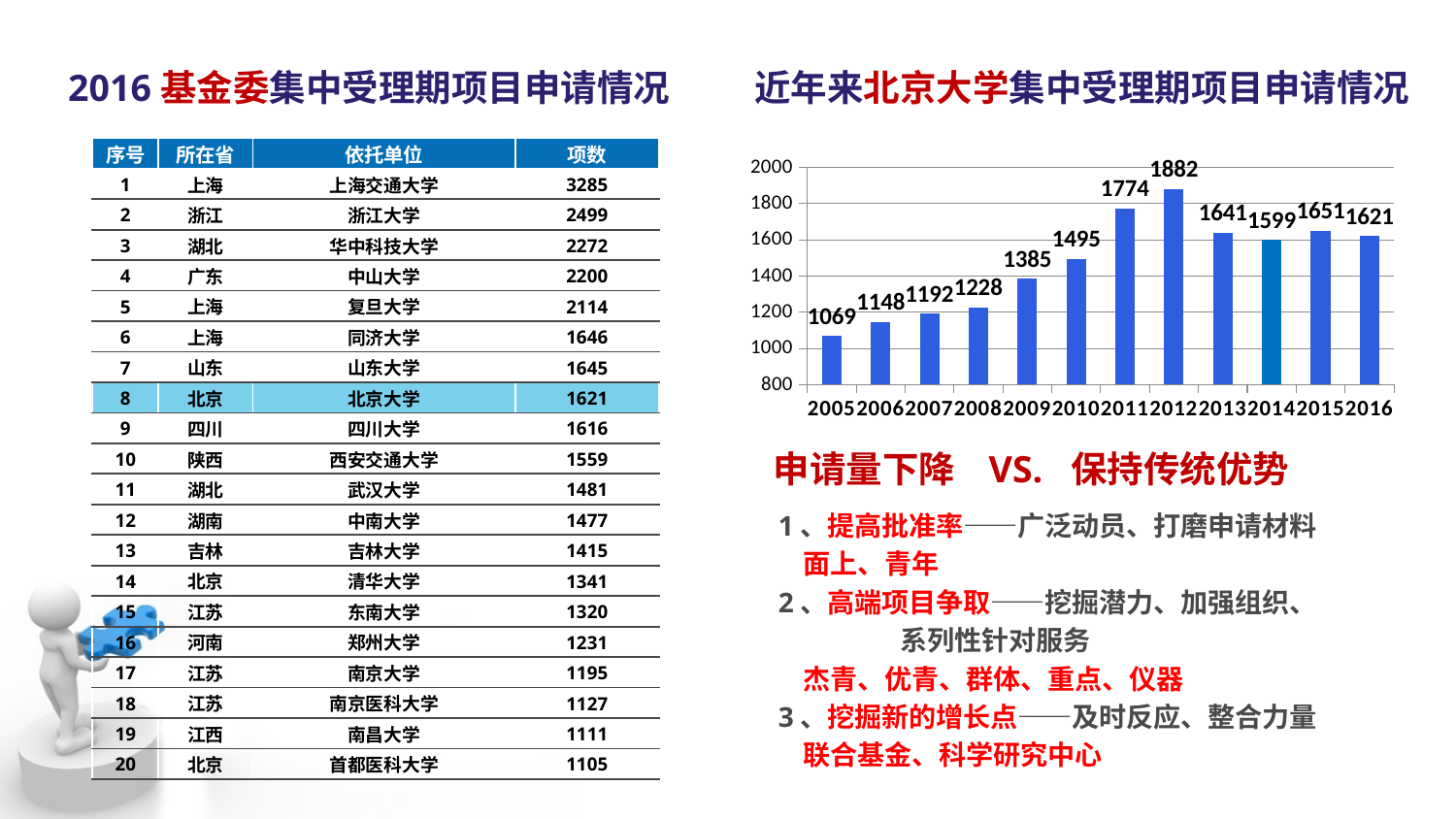
In the bar chart, is the value for 2010 greater or less than 1400? greater In the bar chart, what is the value for 2005? 1069 In the bar chart, what is the value for 2012? 1882 In the bar chart, which year has the lowest value? 2005 In the bar chart, what is the difference between the values for 2016 and 2005? 552 In the bar chart, which year has the highest value? 2012 In the bar chart, what is the value for 2016? 1621 How many years are shown on the x axis of the bar chart? 12 In the bar chart, which is larger, the value for 2013 or the value for 2014? 2013 What kind of chart is shown on the right side of the slide? bar chart In the bar chart, do the values rise or fall from 2005 to 2012? rise In the bar chart, what is the difference between the values for 2012 and 2011? 108